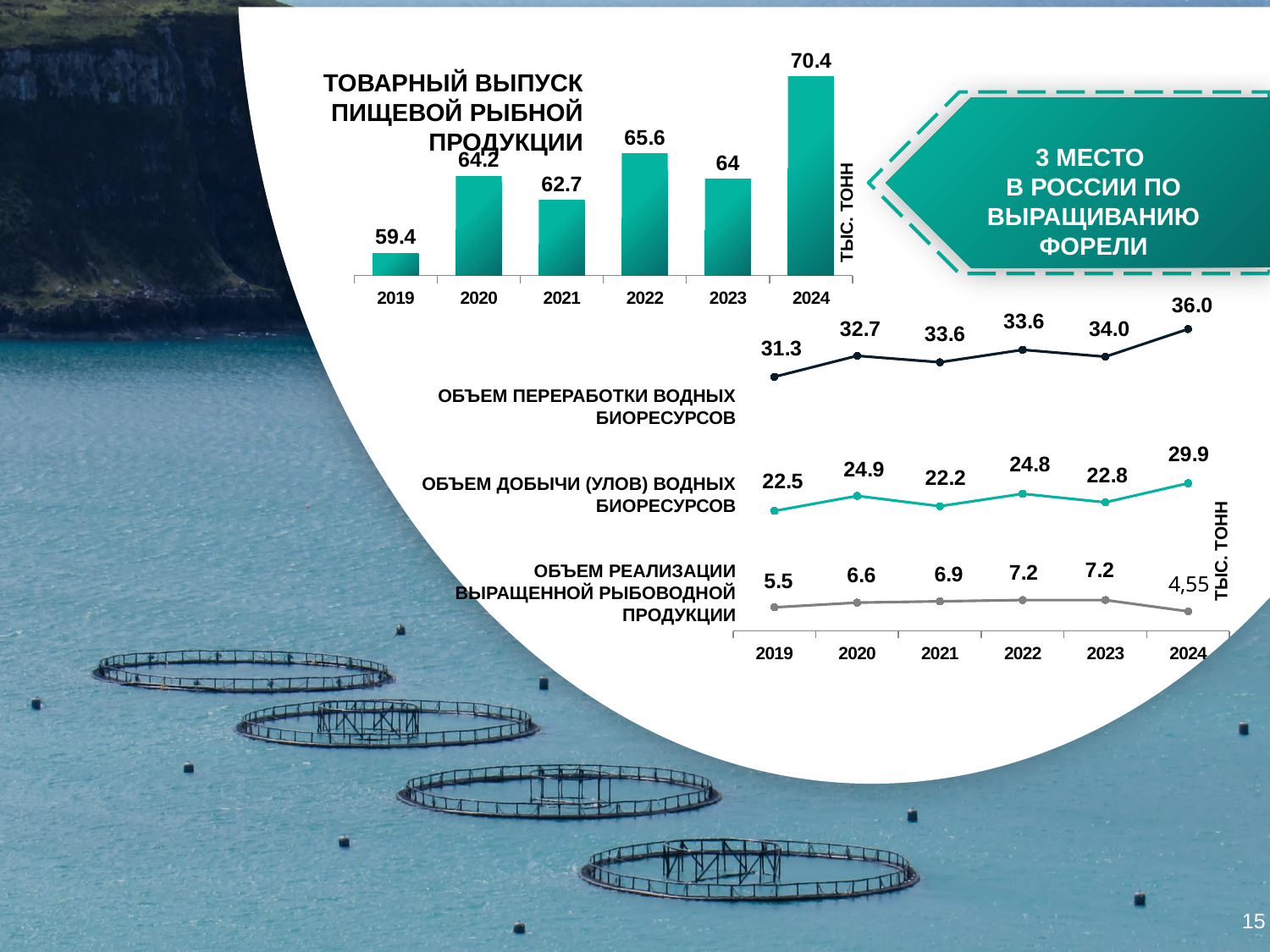
What type of chart is 'ТОВАРНЫЙ ВЫПУСК ПИЩЕВОЙ РЫБНОЙ ПРОДУКЦИИ'? Bar chart In the line chart in the lower right, how many series are plotted? 3 In the bar chart 'ТОВАРНЫЙ ВЫПУСК ПИЩЕВОЙ РЫБНОЙ ПРОДУКЦИИ', what is the value for 2024? 70.4 In the bar chart 'ТОВАРНЫЙ ВЫПУСК ПИЩЕВОЙ РЫБНОЙ ПРОДУКЦИИ', which year has the lowest value? 2019 In the line chart in the lower right, what is the unit shown on the vertical axis label? ТЫС. ТОНН In the bar chart 'ТОВАРНЫЙ ВЫПУСК ПИЩЕВОЙ РЫБНОЙ ПРОДУКЦИИ', which year has the highest value? 2024 In the line chart in the lower right, which is larger in 2023: 'ОБЪЕМ ПЕРЕРАБОТКИ ВОДНЫХ БИОРЕСУРСОВ' or 'ОБЪЕМ ДОБЫЧИ (УЛОВ) ВОДНЫХ БИОРЕСУРСОВ'? ОБЪЕМ ПЕРЕРАБОТКИ ВОДНЫХ БИОРЕСУРСОВ In the line chart in the lower right, what is the value of 'ОБЪЕМ ДОБЫЧИ (УЛОВ) ВОДНЫХ БИОРЕСУРСОВ' in 2021? 22.2 In the line chart in the lower right, what is the value of 'ОБЪЕМ ПЕРЕРАБОТКИ ВОДНЫХ БИОРЕСУРСОВ' in 2024? 36.0 In the line chart in the lower right, what is the value of 'ОБЪЕМ РЕАЛИЗАЦИИ ВЫРАЩЕННОЙ РЫБОВОДНОЙ ПРОДУКЦИИ' in 2024? 4,55 In the bar chart 'ТОВАРНЫЙ ВЫПУСК ПИЩЕВОЙ РЫБНОЙ ПРОДУКЦИИ', what is the difference between the 2024 and 2019 values? 11 In the bar chart 'ТОВАРНЫЙ ВЫПУСК ПИЩЕВОЙ РЫБНОЙ ПРОДУКЦИИ', how many years are shown? 6